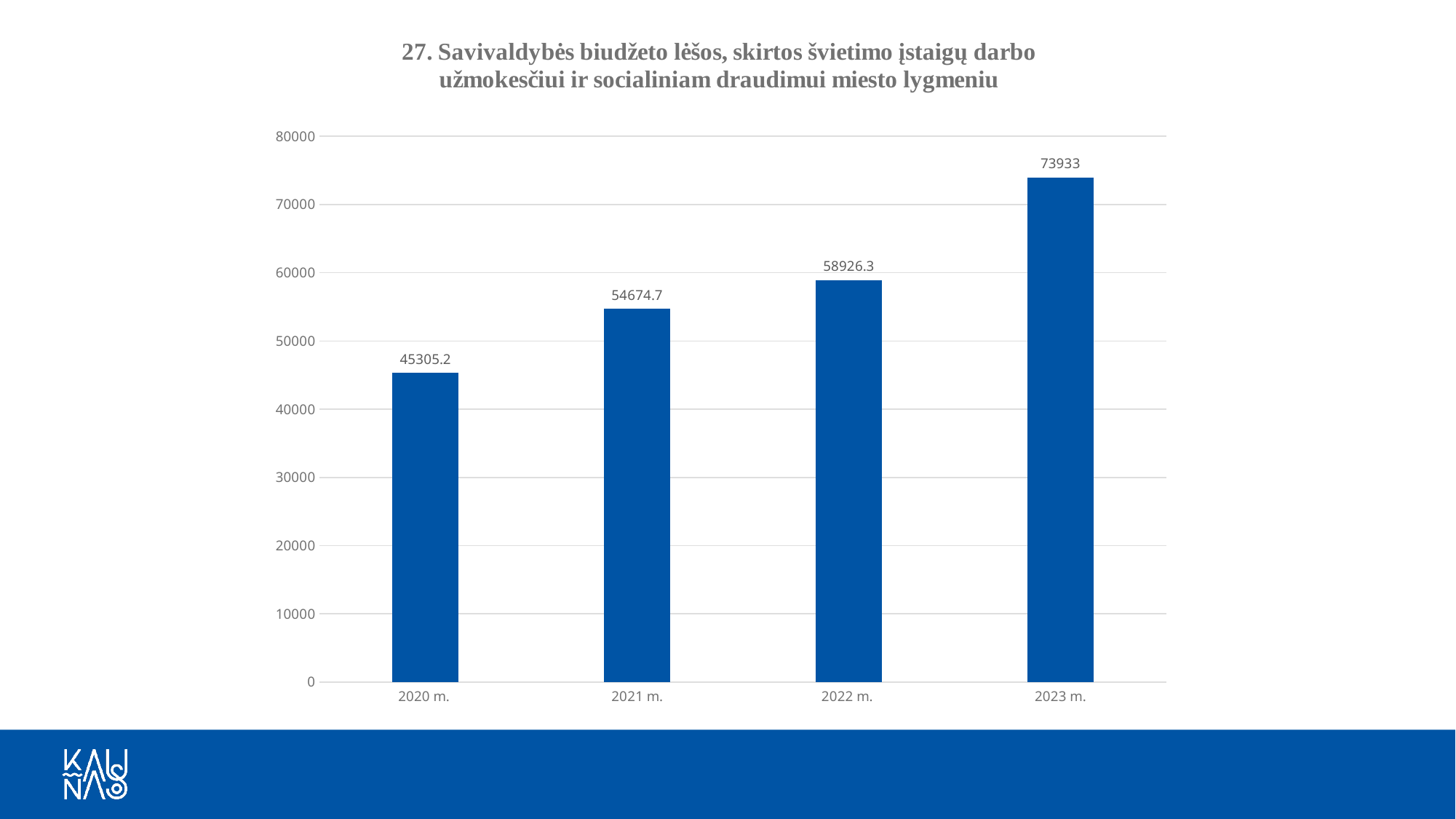
What is the difference between the values for 2023 m. and 2020 m.? 28627.8 What is the difference between the values for 2022 m. and 2021 m.? 4251.6 What is the value for 2022 m.? 58926.3 Which is larger, the value for 2021 m. or the value for 2022 m.? 2022 m. How many bars are shown in the chart? 4 Which year has the highest value? 2023 m. What is the value for 2023 m.? 73933 What is the value for 2021 m.? 54674.7 Do the values rise or fall from 2020 m. to 2023 m.? rise What is the value for 2020 m.? 45305.2 Is the value for 2023 m. greater or less than 70000? greater Which year has the lowest value? 2020 m.